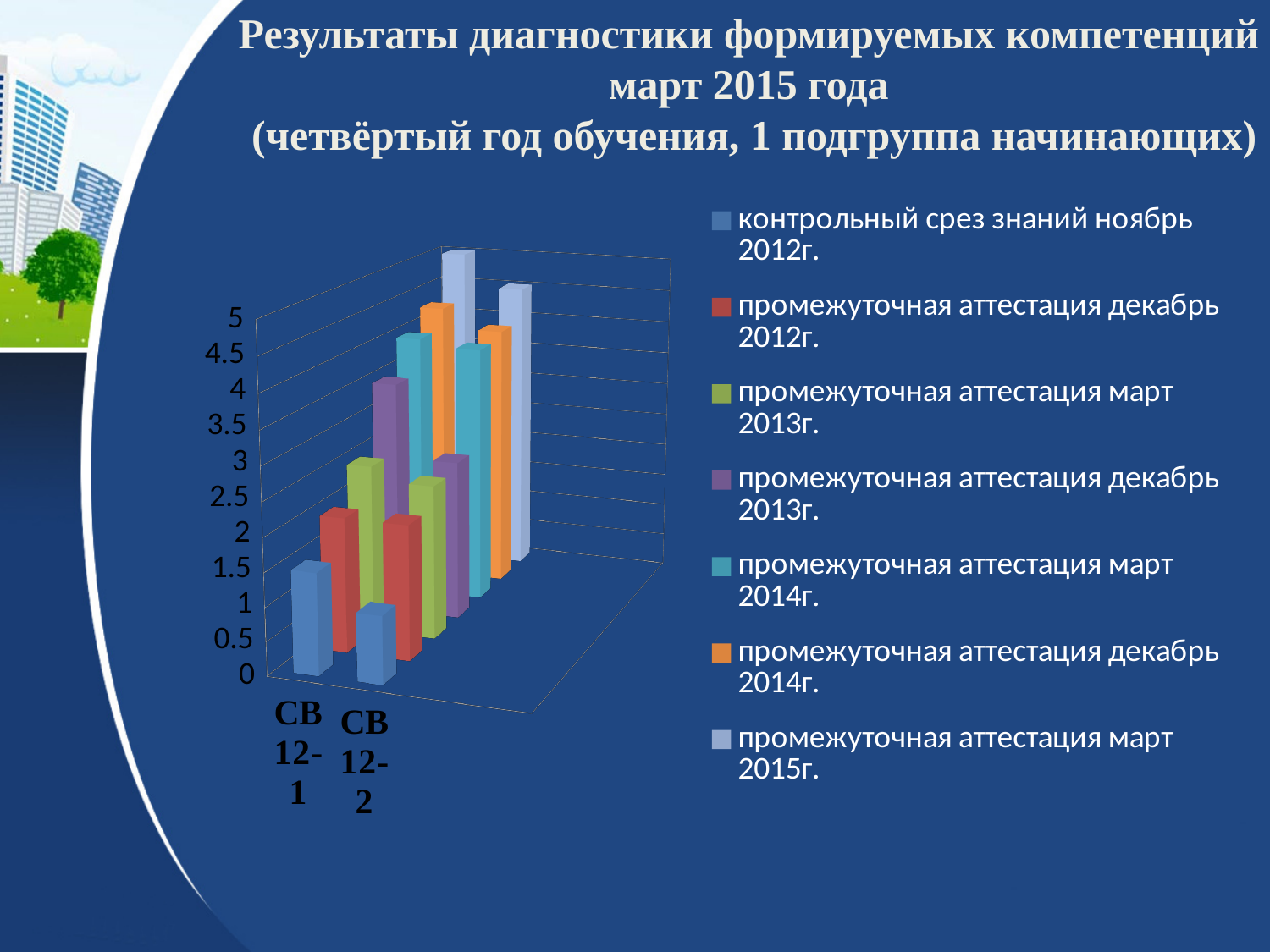
What kind of chart is shown on the slide? bar chart Which series has the lowest value for СВ 12-2? контрольный срез знаний ноябрь 2012г. Is the value for контрольный срез знаний ноябрь 2012г. for СВ 12-1 greater or less than 3? less How many categories are shown on the x axis of the chart? 2 What is the last series listed in the chart legend? промежуточная аттестация март 2015г. How many series does the chart legend list? 7 Which series has the highest value for СВ 12-1? промежуточная аттестация март 2015г. For СВ 12-1, do the values rise or fall from контрольный срез знаний ноябрь 2012г. to промежуточная аттестация март 2015г.? rise For СВ 12-1, which is larger: промежуточная аттестация март 2015г. or контрольный срез знаний ноябрь 2012г.? промежуточная аттестация март 2015г. What is the first series listed in the chart legend? контрольный срез знаний ноябрь 2012г. Which series has the lowest value for СВ 12-1? контрольный срез знаний ноябрь 2012г. Is the value for промежуточная аттестация март 2015г. for СВ 12-1 greater or less than 3? greater